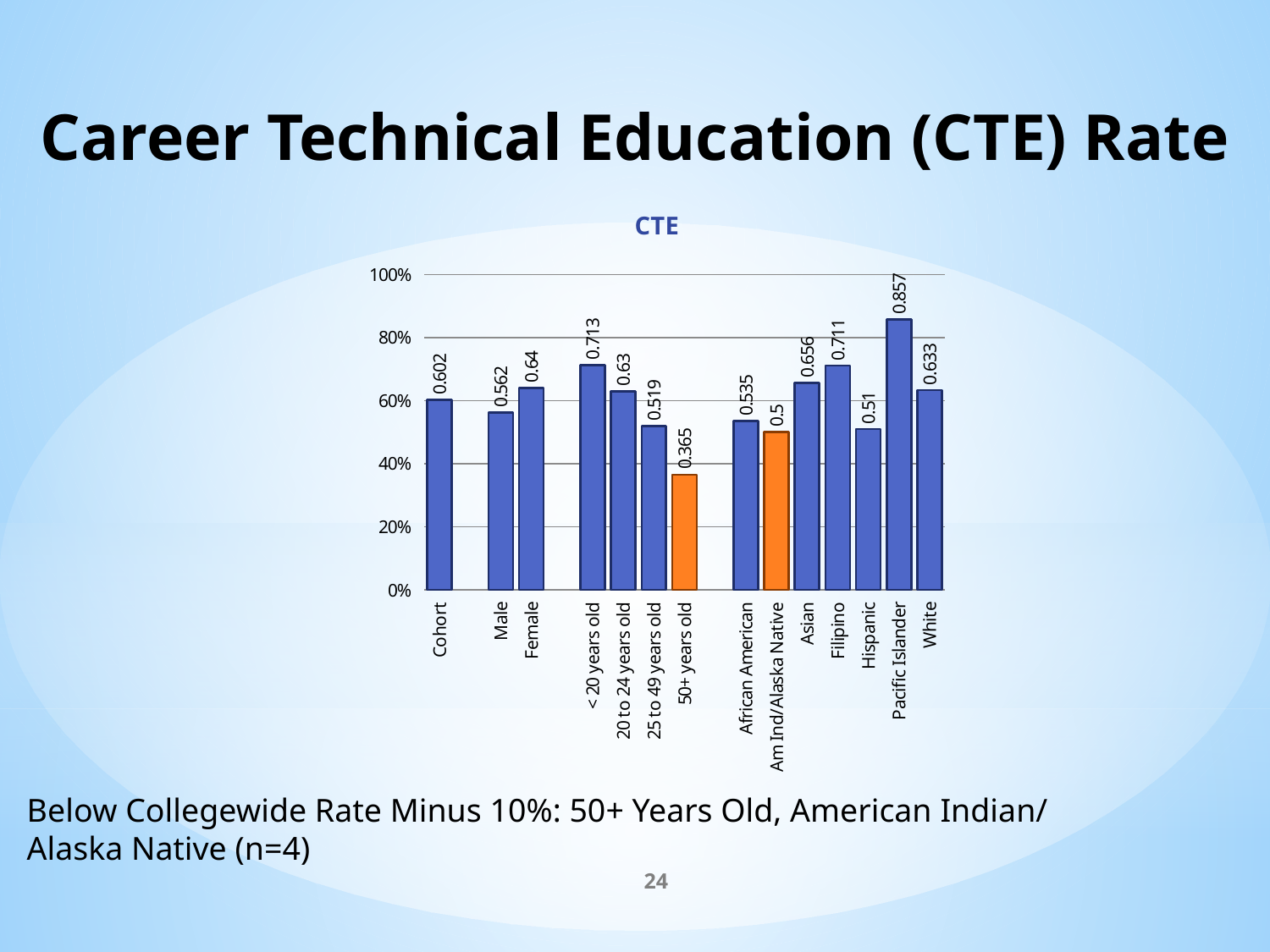
Which has a larger value, < 20 years old or 20 to 24 years old? < 20 years old What kind of chart is shown on the slide? bar chart Which two bars are coloured orange instead of blue? 50+ years old and Am Ind/Alaska Native What is the value shown for 50+ years old? 0.365 How many categories (bars) are shown in the chart? 14 What is the difference between the values for Female and Male? 0.078 Which category has the lowest value in the chart? 50+ years old Which category has the highest value in the chart? Pacific Islander What is the CTE rate value shown for the Cohort bar? 0.602 What is the value shown for Pacific Islander? 0.857 Is the value for Hispanic greater or less than 60%? less What is the value shown for Am Ind/Alaska Native? 0.5